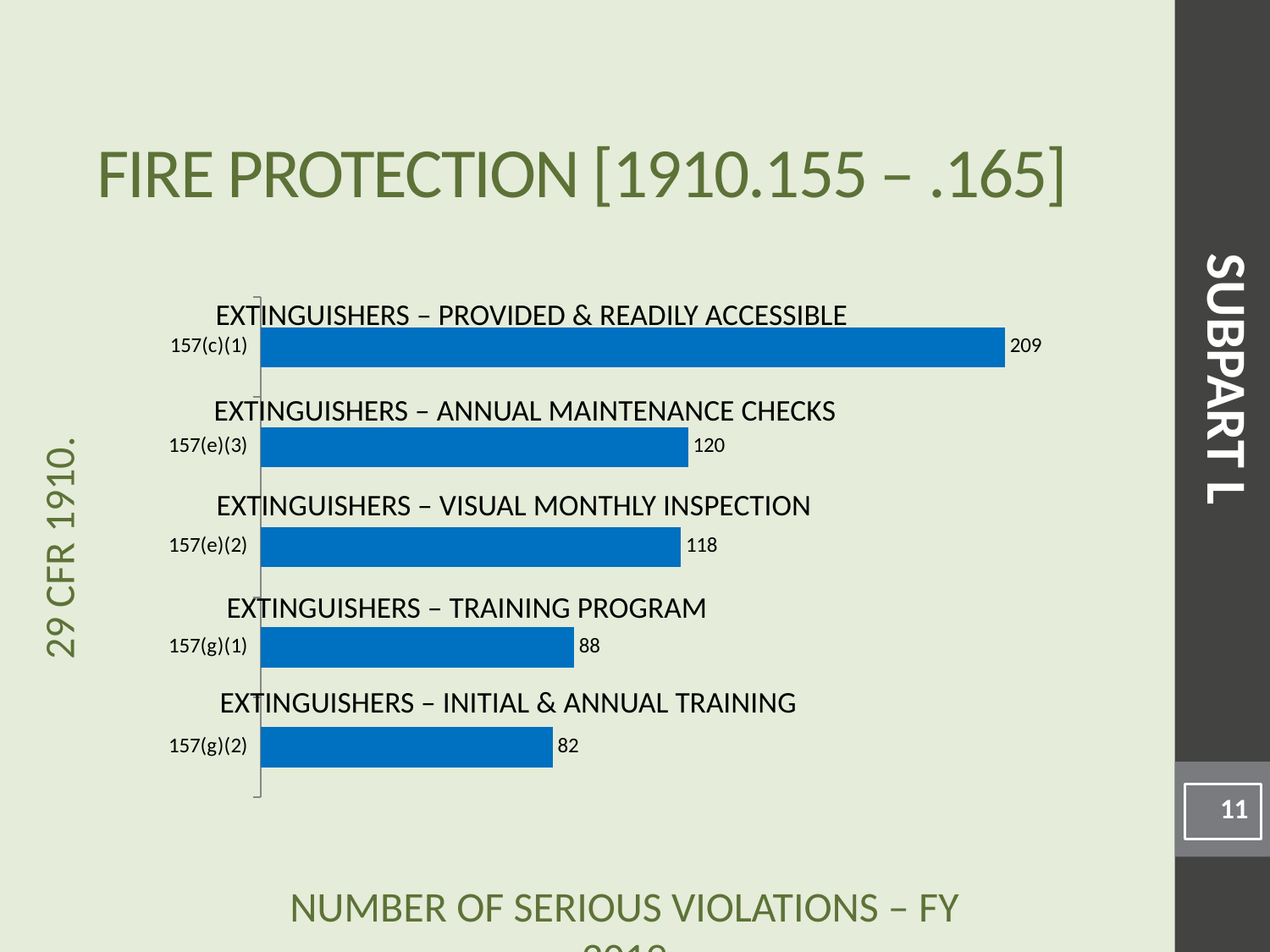
What is the difference between the values for 157(c)(1) and 157(e)(3)? 89 What is the number of serious violations for 157(c)(1)? 209 What is the number of serious violations for 157(g)(2)? 82 Which has a larger value, 157(e)(2) or 157(g)(1)? 157(e)(2) How many categories are shown in the chart? 5 What kind of chart is shown on the slide? Bar chart What is the difference between the values for 157(g)(1) and 157(g)(2)? 6 What is the number of serious violations for 157(e)(3)? 120 Which category has the lowest number of serious violations? 157(g)(2) What colour are the bars in the chart? Blue Which category has the highest number of serious violations? 157(c)(1) What is the value for 157(e)(2)? 118